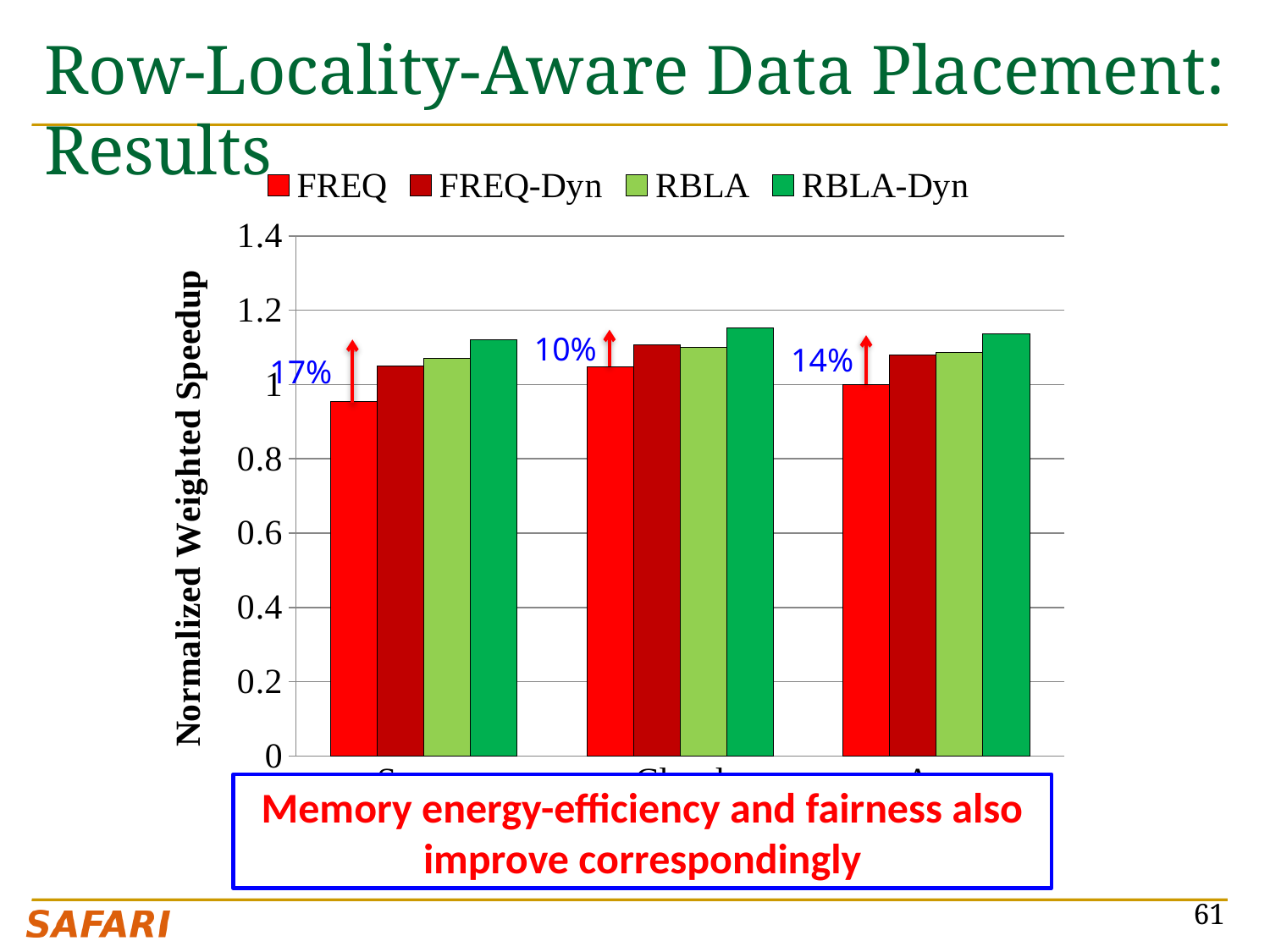
What percentage improvement is annotated above the first (leftmost) group of bars? 17% How many series does the legend list? 4 Is the value for RBLA-Dyn in the middle group greater or less than 1? greater In the first (leftmost) group of bars, which series has the lowest value? FREQ In the first (leftmost) group of bars, which series has the highest value? RBLA-Dyn What is the title of the y axis? Normalized Weighted Speedup How many groups of bars are plotted along the x axis? 3 In the middle group of bars, which series has the lowest value? FREQ In the rightmost group, which is larger: the FREQ bar or the RBLA-Dyn bar? RBLA-Dyn Is the value for FREQ in the first (leftmost) group greater or less than 0.8? greater In the rightmost group of bars, which series has the highest value? RBLA-Dyn What kind of chart is shown on the slide? bar chart